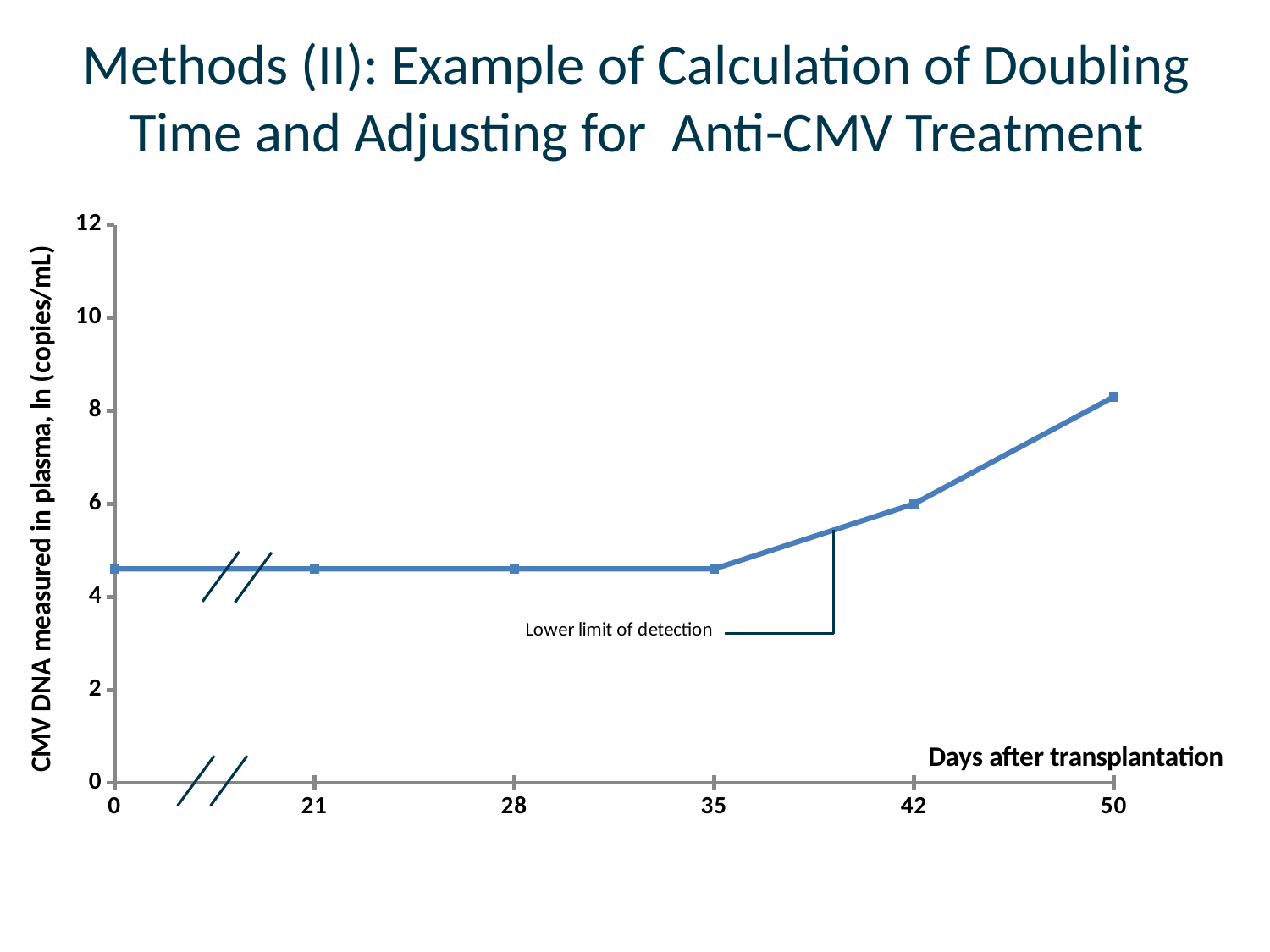
How many data points are plotted on the line? 6 Is the value at day 35 greater or less than 4? greater What kind of chart is shown on the slide? line chart Do the values rise or fall between day 35 and day 50? rise Is the value at day 28 greater or less than 6? less Is the value at day 0 greater or less than 6? less What does the annotation pointing to the flat part of the line say? Lower limit of detection What is the label of the x axis? Days after transplantation What is the CMV DNA value at day 42? 6 At which day after transplantation is the CMV DNA value highest? 50 Which has the larger value, day 42 or day 50? day 50